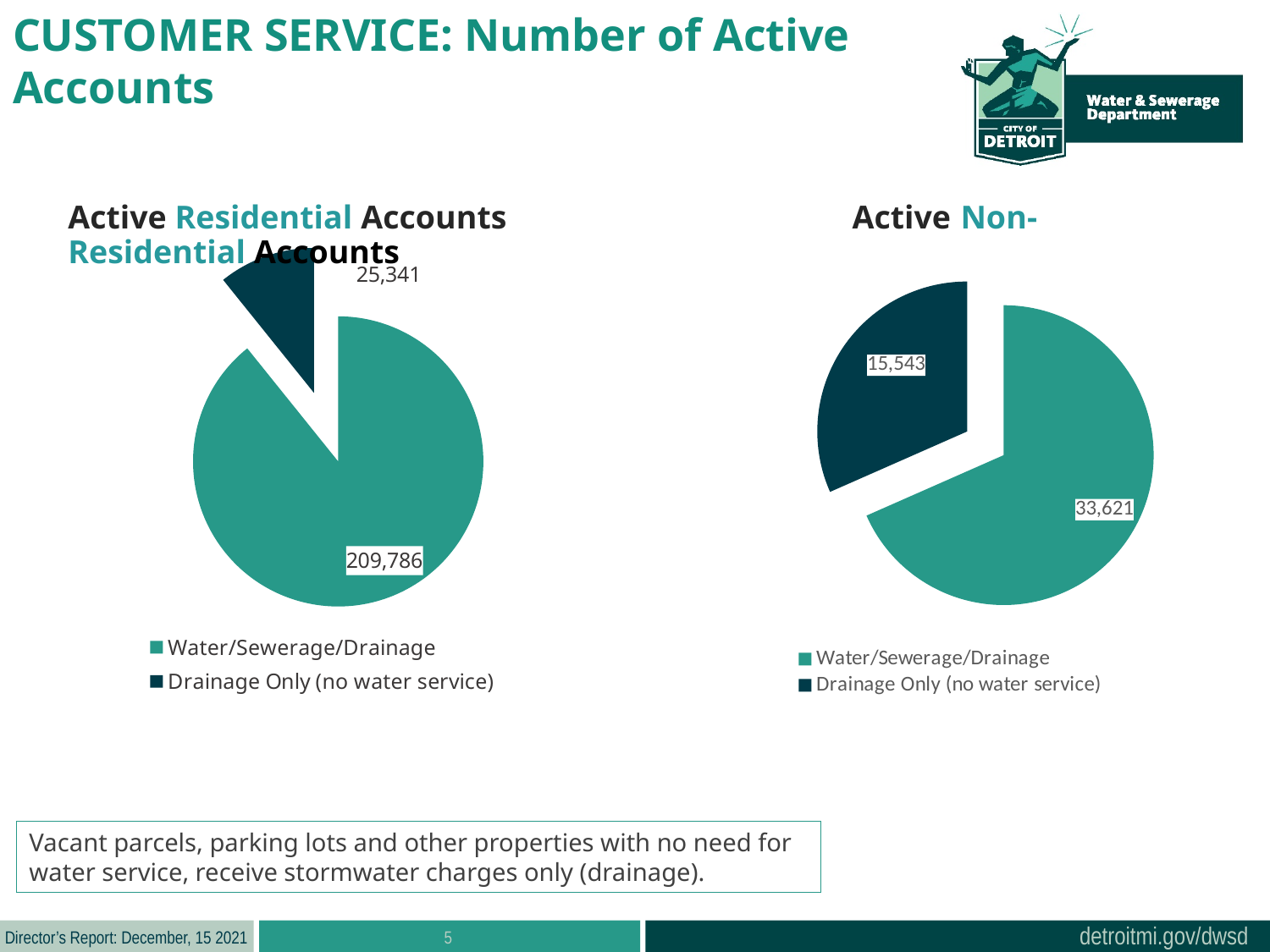
In the Active Non-Residential Accounts chart, how many Water/Sewerage/Drainage accounts are there? 33,621 In the Active Residential Accounts chart, how many Water/Sewerage/Drainage accounts are there? 209,786 In the Active Non-Residential Accounts chart, which category has the smallest slice? Drainage Only (no water service) In the Active Residential Accounts chart, how many Drainage Only (no water service) accounts are there? 25,341 What is the total number of accounts shown in the Active Non-Residential Accounts chart? 49,164 How many categories does the legend of the Active Non-Residential Accounts chart list? 2 Which is larger: the Drainage Only value in the Active Residential Accounts chart or the Drainage Only value in the Active Non-Residential Accounts chart? Active Residential Accounts In the Active Non-Residential Accounts chart, what is the difference between the Water/Sewerage/Drainage and Drainage Only values? 18,078 In the Active Residential Accounts chart, which category has the largest slice? Water/Sewerage/Drainage In the Active Non-Residential Accounts chart, how many Drainage Only (no water service) accounts are there? 15,543 In the Active Residential Accounts chart, what is the difference between the Water/Sewerage/Drainage and Drainage Only values? 184,445 What type of chart is used for the Active Residential Accounts? Pie chart